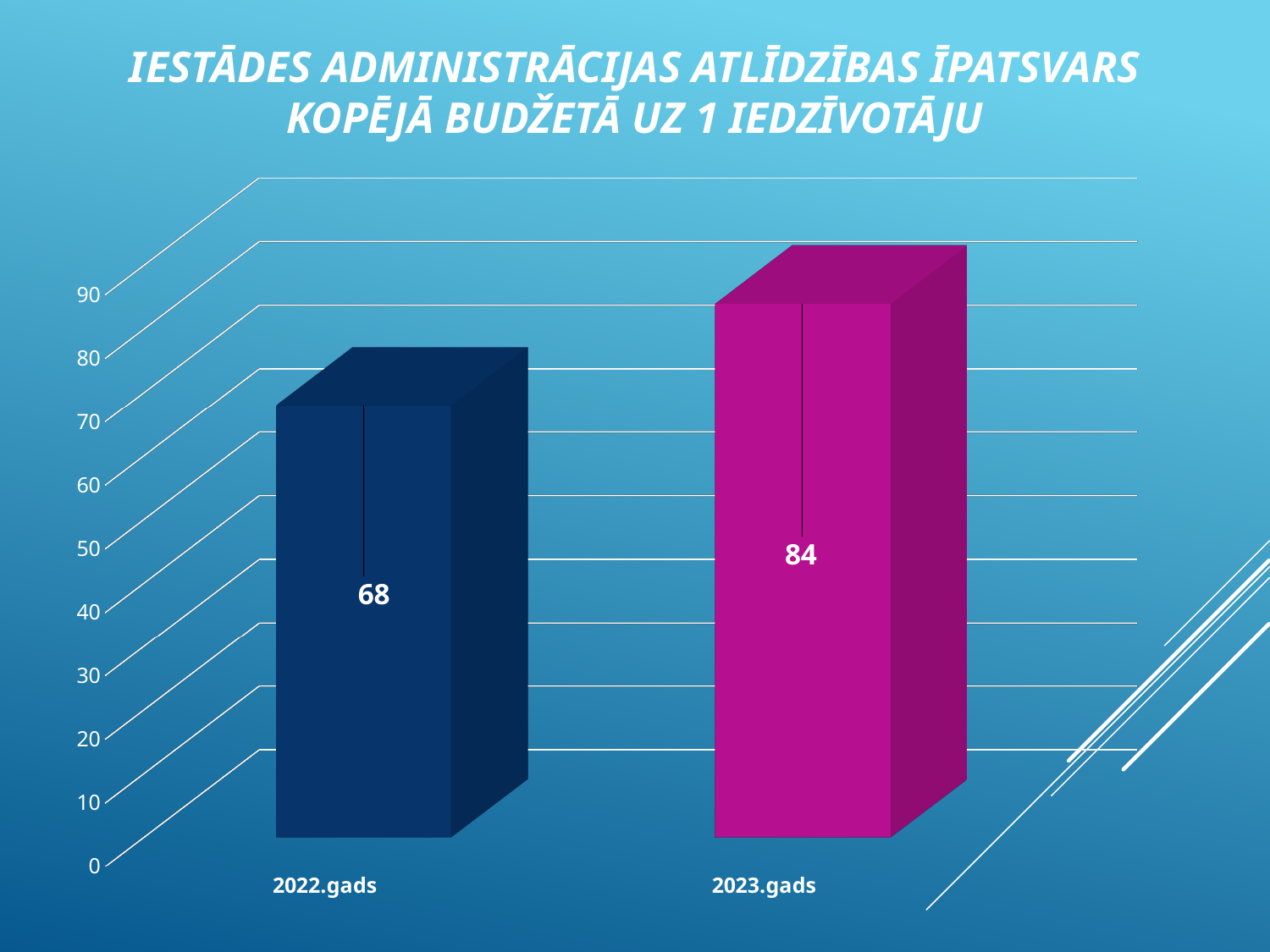
What kind of chart is shown on the slide? bar chart What is the value for 2023.gads? 84 Which year has the lowest value? 2022.gads Is the value for 2023.gads greater or less than 80? greater Which year has the highest value? 2023.gads What is the value for 2022.gads? 68 Is the value for 2022.gads greater or less than 70? less Do the values rise or fall from 2022.gads to 2023.gads? rise Which is larger, the value for 2022.gads or the value for 2023.gads? 2023.gads How many categories are shown on the x axis? 2 What is the title of the chart? Iestādes administrācijas atlīdzības īpatsvars kopējā budžetā uz 1 iedzīvotāju What is the difference between the values for 2023.gads and 2022.gads? 16